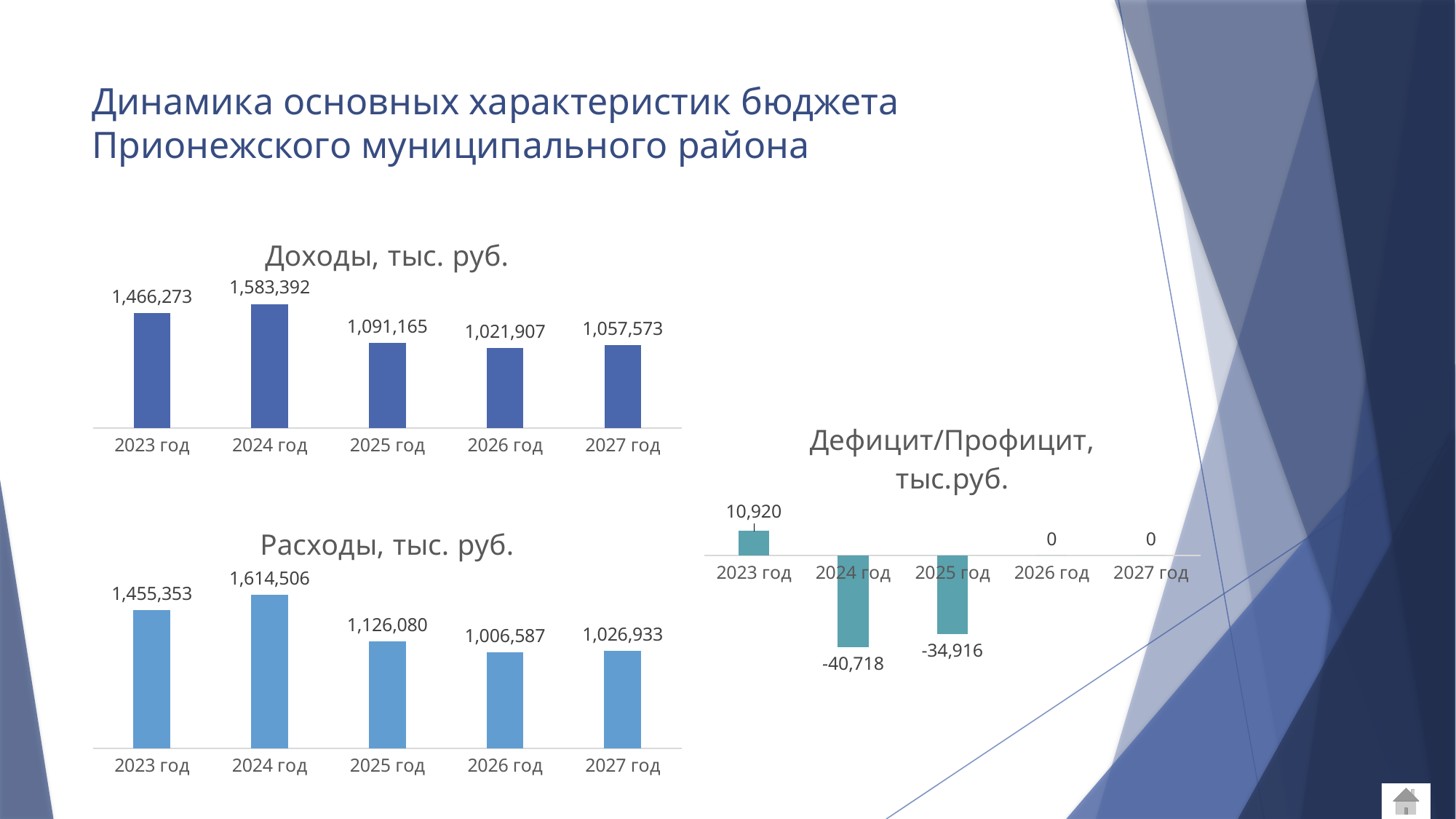
In the chart titled "Дефицит/Профицит, тыс.руб.", what is the value for 2024 год? -40,718 In the chart titled "Доходы, тыс. руб.", what is the value for 2024 год? 1,583,392 In the chart titled "Дефицит/Профицит, тыс.руб.", what is the value for 2023 год? 10,920 In the chart titled "Расходы, тыс. руб.", what is the value for 2027 год? 1,026,933 In the chart titled "Расходы, тыс. руб.", which year has the highest value? 2024 год In the chart titled "Дефицит/Профицит, тыс.руб.", which year has the lowest value? 2024 год How many years are shown on the x axis of the chart titled "Доходы, тыс. руб."? 5 In the chart titled "Доходы, тыс. руб.", what is the difference between the values for 2024 год and 2023 год? 117,119 What kind of chart is the chart titled "Расходы, тыс. руб."? Bar chart In the chart titled "Расходы, тыс. руб.", which is larger, the value for 2025 год or 2026 год? 2025 год In the chart titled "Доходы, тыс. руб.", which year has the lowest value? 2026 год In the chart titled "Доходы, тыс. руб.", do the values rise or fall from 2024 год to 2026 год? Fall